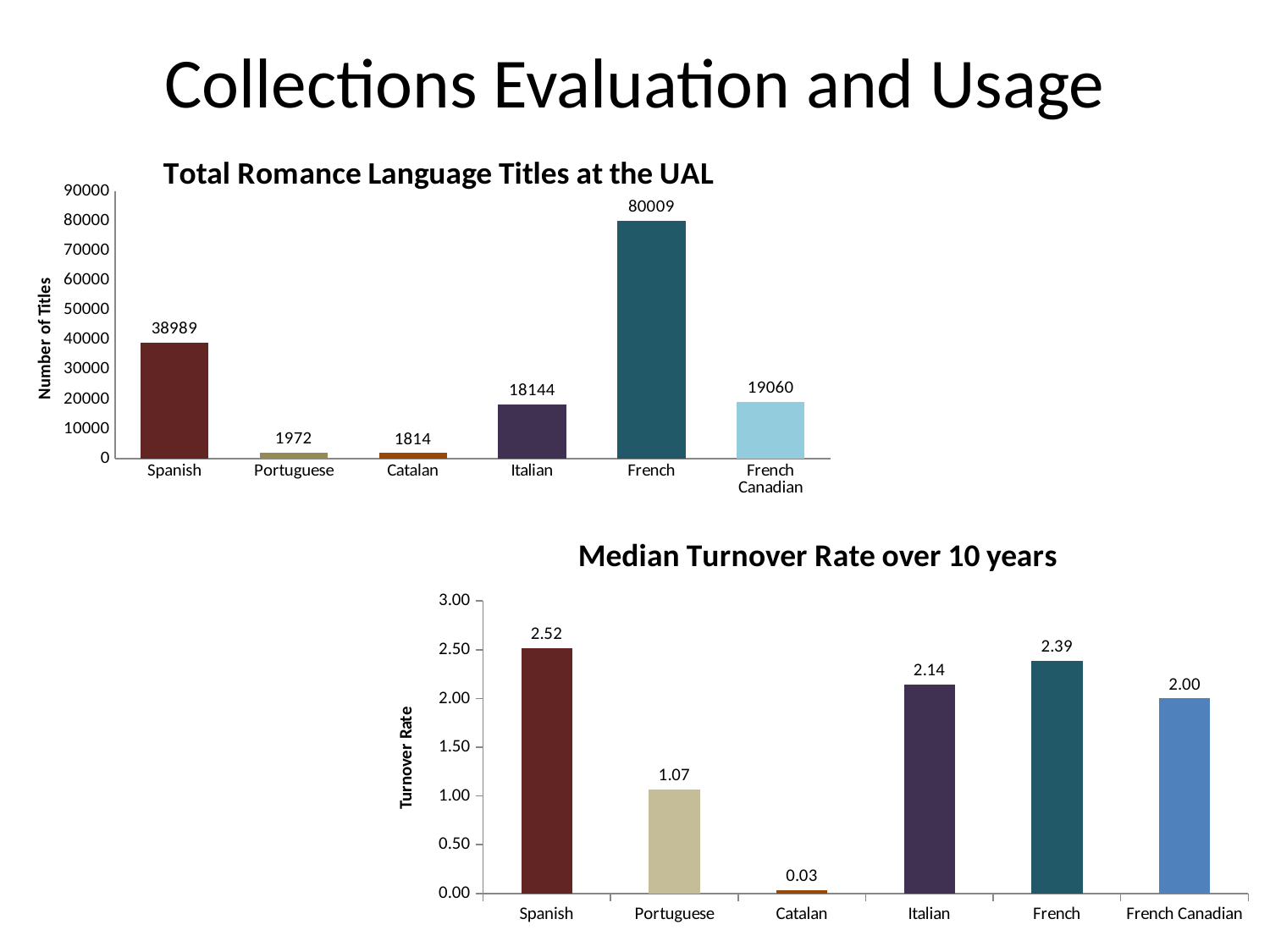
In the 'Median Turnover Rate over 10 years' chart, is the value for Portuguese greater or less than 1.50? less In the 'Total Romance Language Titles at the UAL' chart, what is the y-axis label? Number of Titles In the 'Total Romance Language Titles at the UAL' chart, which has more titles, French Canadian or Italian? French Canadian In the 'Total Romance Language Titles at the UAL' chart, how many language categories are shown? 6 In the 'Median Turnover Rate over 10 years' chart, what is the turnover rate for Catalan? 0.03 In the 'Total Romance Language Titles at the UAL' chart, what is the difference between the Spanish and Italian title counts? 20845 In the 'Total Romance Language Titles at the UAL' chart, how many titles are there for French? 80009 In the 'Median Turnover Rate over 10 years' chart, what is the difference between the Spanish and French turnover rates? 0.13 What type of chart is 'Median Turnover Rate over 10 years'? Bar chart In the 'Median Turnover Rate over 10 years' chart, which language has the highest turnover rate? Spanish In the 'Median Turnover Rate over 10 years' chart, what is the turnover rate for French Canadian? 2.00 In the 'Total Romance Language Titles at the UAL' chart, which language has the fewest titles? Catalan